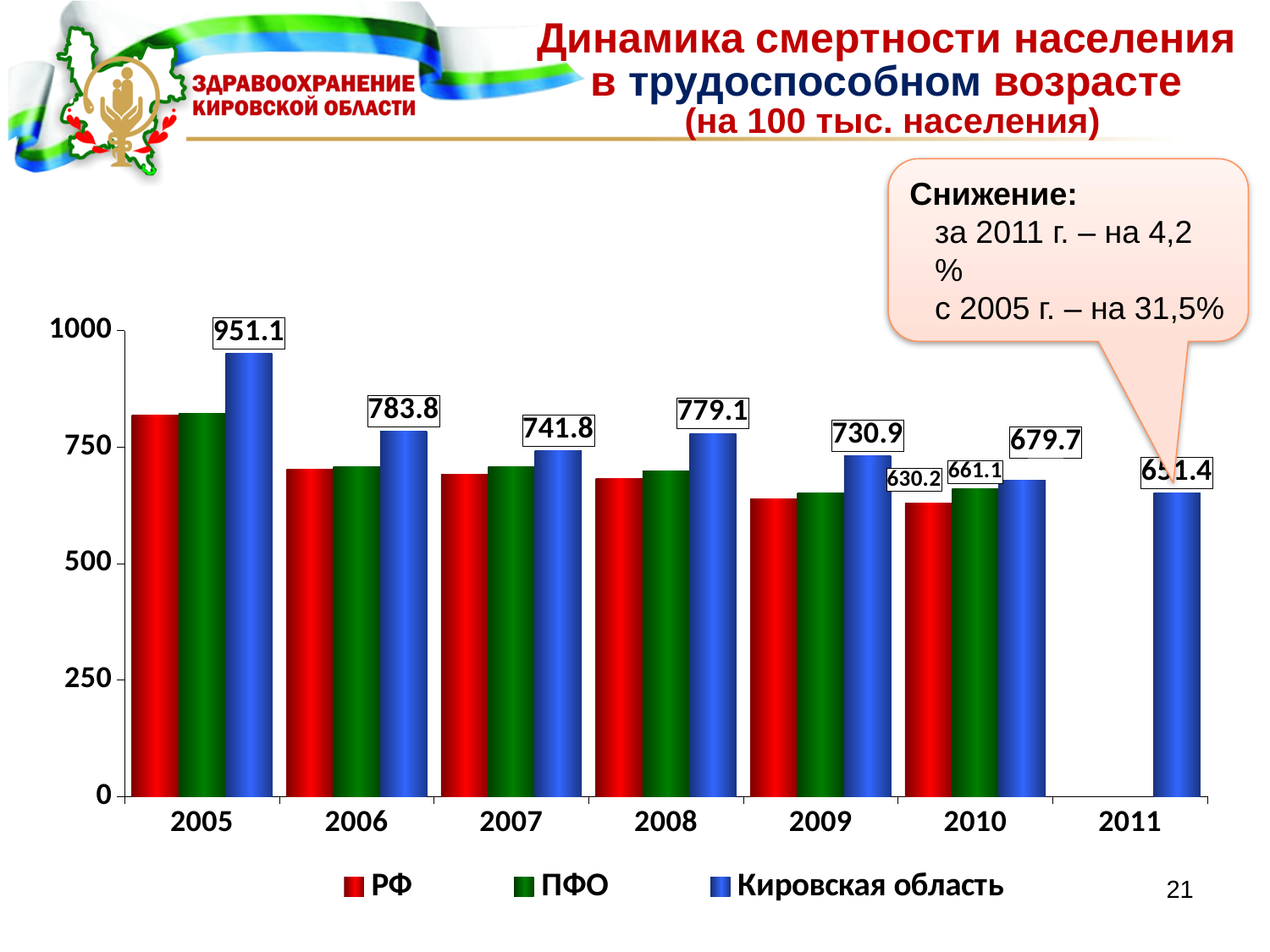
What is the value for РФ in 2010? 630.2 What is the difference between the Кировская область values for 2005 and 2010? 271.4 How many years are shown on the x axis? 7 What is the value for Кировская область in 2005? 951.1 Which year has the larger value for Кировская область, 2007 or 2008? 2008 What kind of chart is shown on the slide? bar chart Which colour represents Кировская область in the legend? blue How many series does the legend list? 3 Is the value for РФ in 2005 greater or less than 750? greater In which year is the value for Кировская область highest? 2005 What is the value for Кировская область in 2006? 783.8 What is the value for ПФО in 2010? 661.1